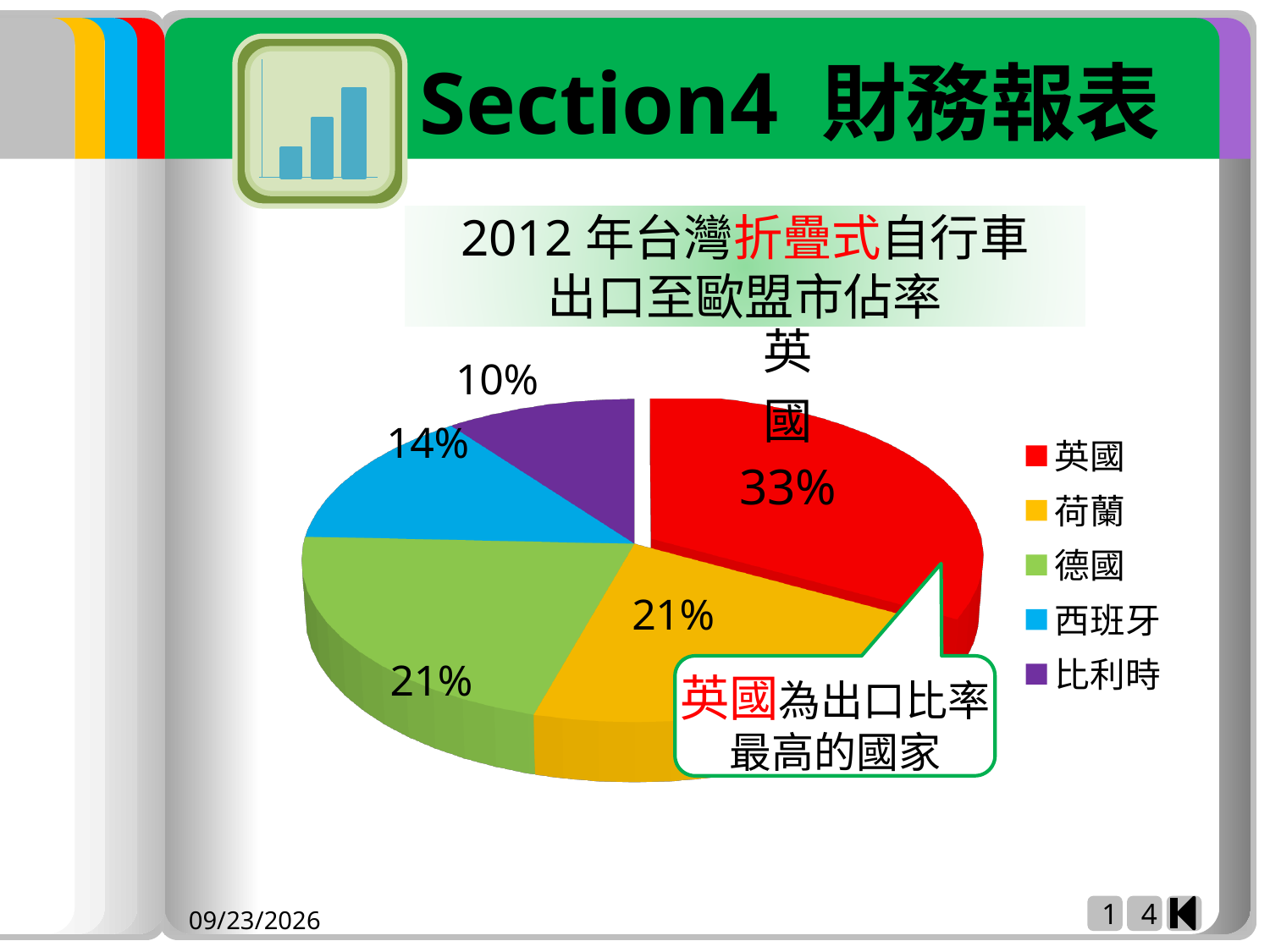
What kind of chart is shown on the slide? pie chart What is the value shown for 德國? 21% How many countries are shown in the pie chart? 5 What is the value shown for 西班牙? 14% What share of the pie does 英國 hold? 33% How many entries does the legend list? 5 What is the value shown for 比利時? 10% Which is larger, the share for 西班牙 or the share for 比利時? 西班牙 Which country has the largest slice of the pie? 英國 What is the difference in percentage points between 英國 and 比利時? 23 What is the title of the chart? 2012 年台灣折疊式自行車出口至歐盟市佔率 Which country has the smallest slice of the pie? 比利時